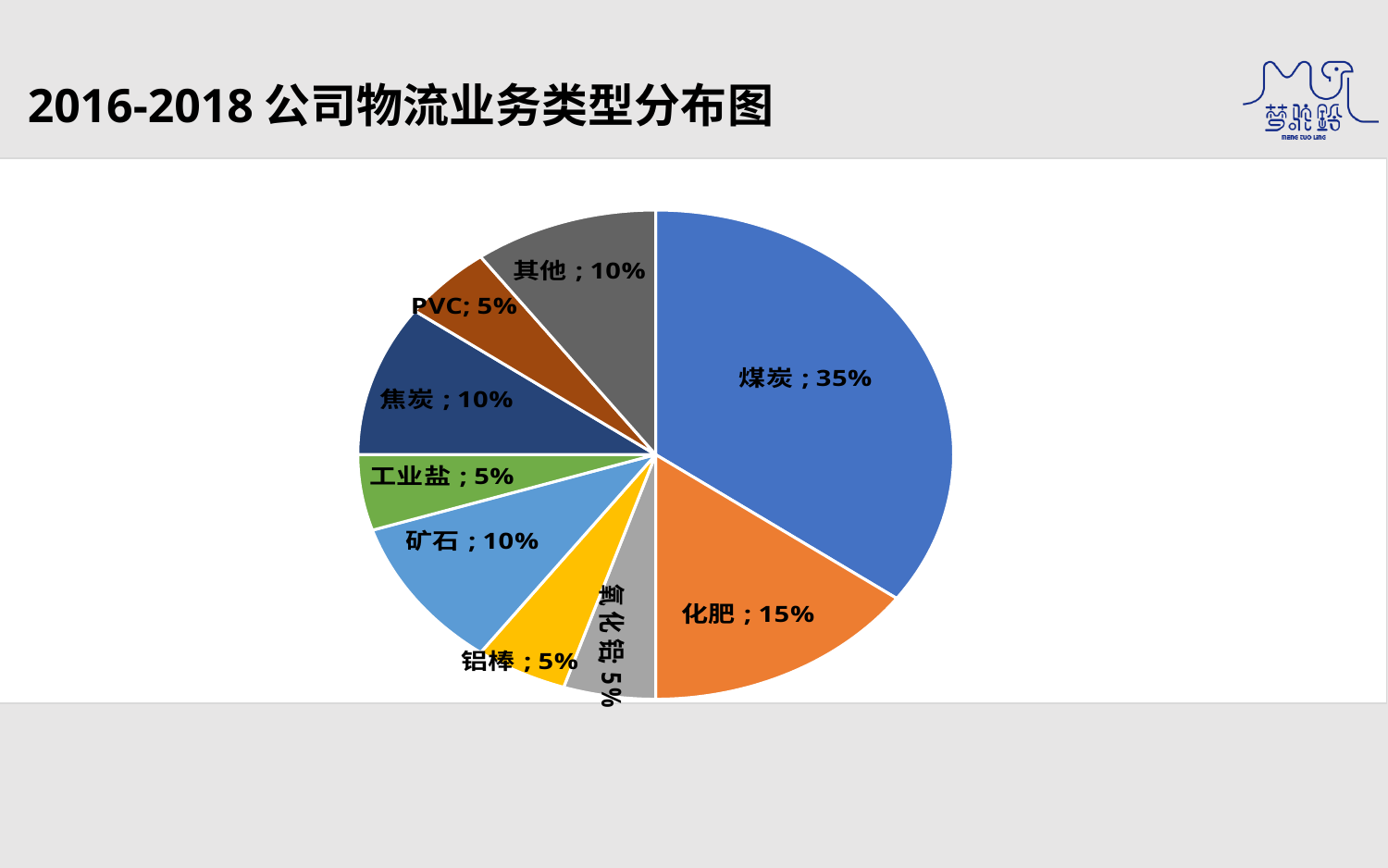
What share of the pie does 煤炭 account for? 35% What colour is the 煤炭 slice? blue What is the value shown for PVC? 5% What is the title of the chart on the slide? 2016-2018 公司物流业务类型分布图 What is the value shown for 矿石? 10% What is the difference between the shares of 其他 and 铝棒? 5% Which is larger, the share for 焦炭 or the share for 工业盐? 焦炭 What kind of chart is shown on the slide? pie chart What share of the pie does 化肥 account for? 15% How many slices does the pie chart have? 9 What is the difference between the shares of 煤炭 and 化肥? 20% Which category has the largest slice of the pie? 煤炭